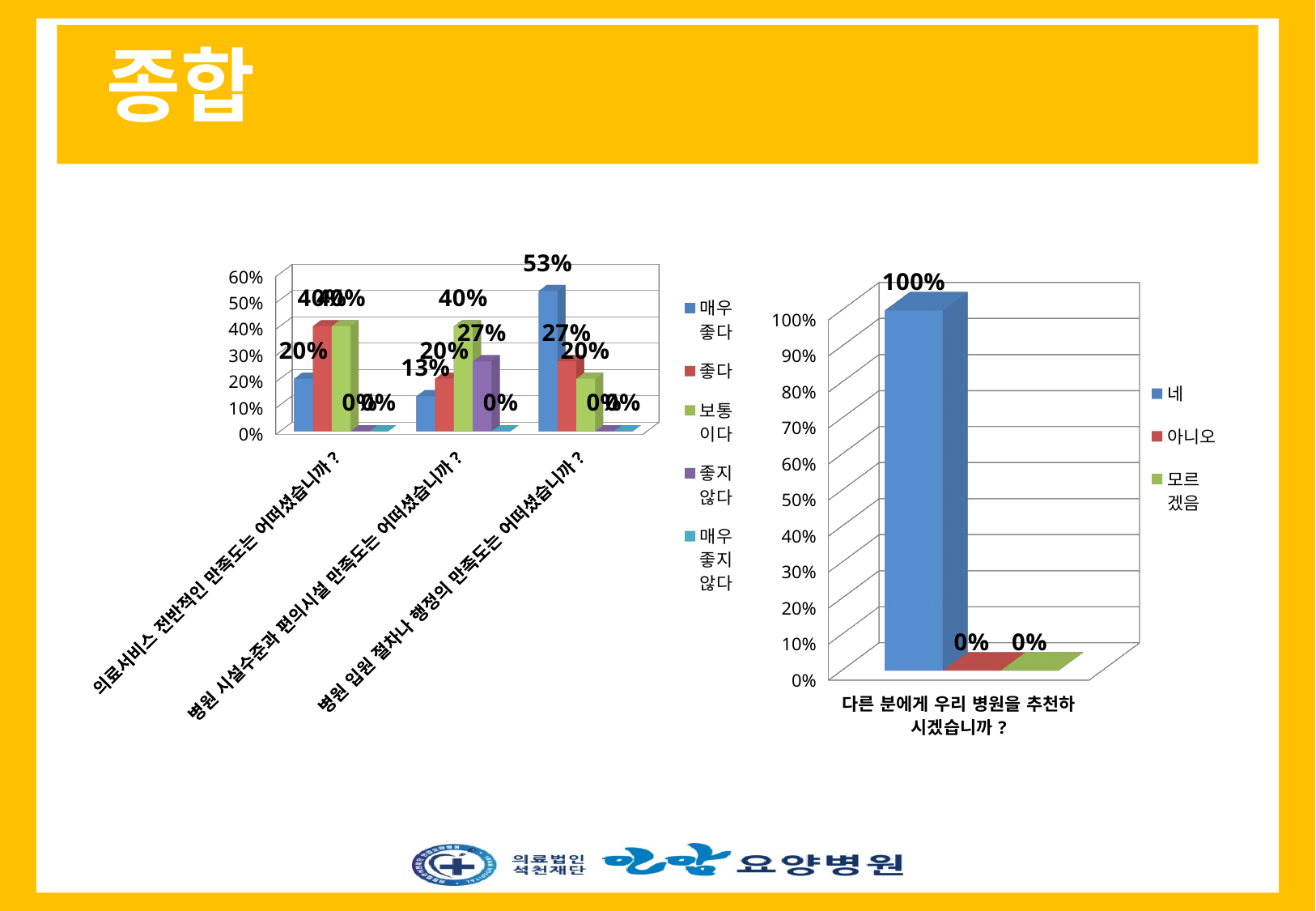
On the right chart, how many series does the legend list? 3 On the right chart, what is the value for 아니오? 0% On the left chart, what is the value for 좋지 않다 in the category 병원 시설수준과 편의시설 만족도는 어떠셨습니까? 27% On the left chart, how many series does the legend list? 5 On the left chart, which is larger in the category 병원 시설수준과 편의시설 만족도는 어떠셨습니까: 보통이다 or 좋다? 보통이다 What kind of chart is the left chart? Bar chart On the left chart, what is the value for 매우 좋다 in the category 병원 시설수준과 편의시설 만족도는 어떠셨습니까? 13% On the right chart, which series has the highest value? 네 On the left chart, what is the difference between 매우 좋다 and 좋다 in the category 병원 입원 절차나 행정의 만족도는 어떠셨습니까? 26% On the left chart, how many categories are shown on the x axis? 3 On the right chart, what is the value for 네? 100% On the left chart, what is the value for 매우 좋다 in the category 병원 입원 절차나 행정의 만족도는 어떠셨습니까? 53%